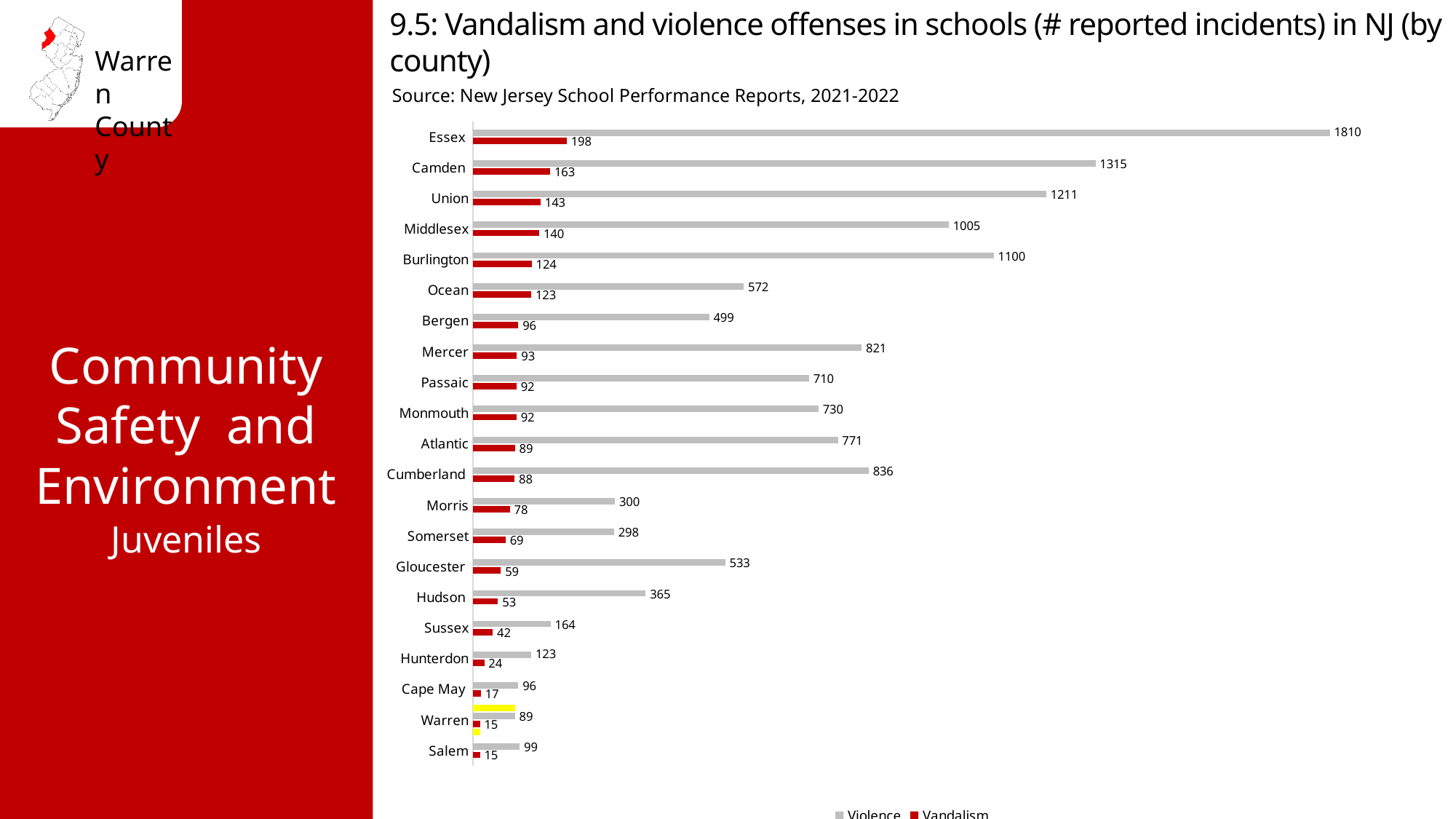
What is the Violence value for Essex? 1810 What is the difference between the Violence values for Camden and Union? 104 How many series does the legend list? 2 What is the Vandalism value for Hunterdon? 24 How many counties are shown in the chart? 21 What is the Vandalism value for Warren? 15 What is the Violence value for Cumberland? 836 Which county has the highest Vandalism value? Essex Which county has a larger Violence value, Burlington or Middlesex? Burlington Which county has the highest Violence value? Essex What kind of chart is shown on the slide? Bar chart Which county has the lowest Violence value? Warren